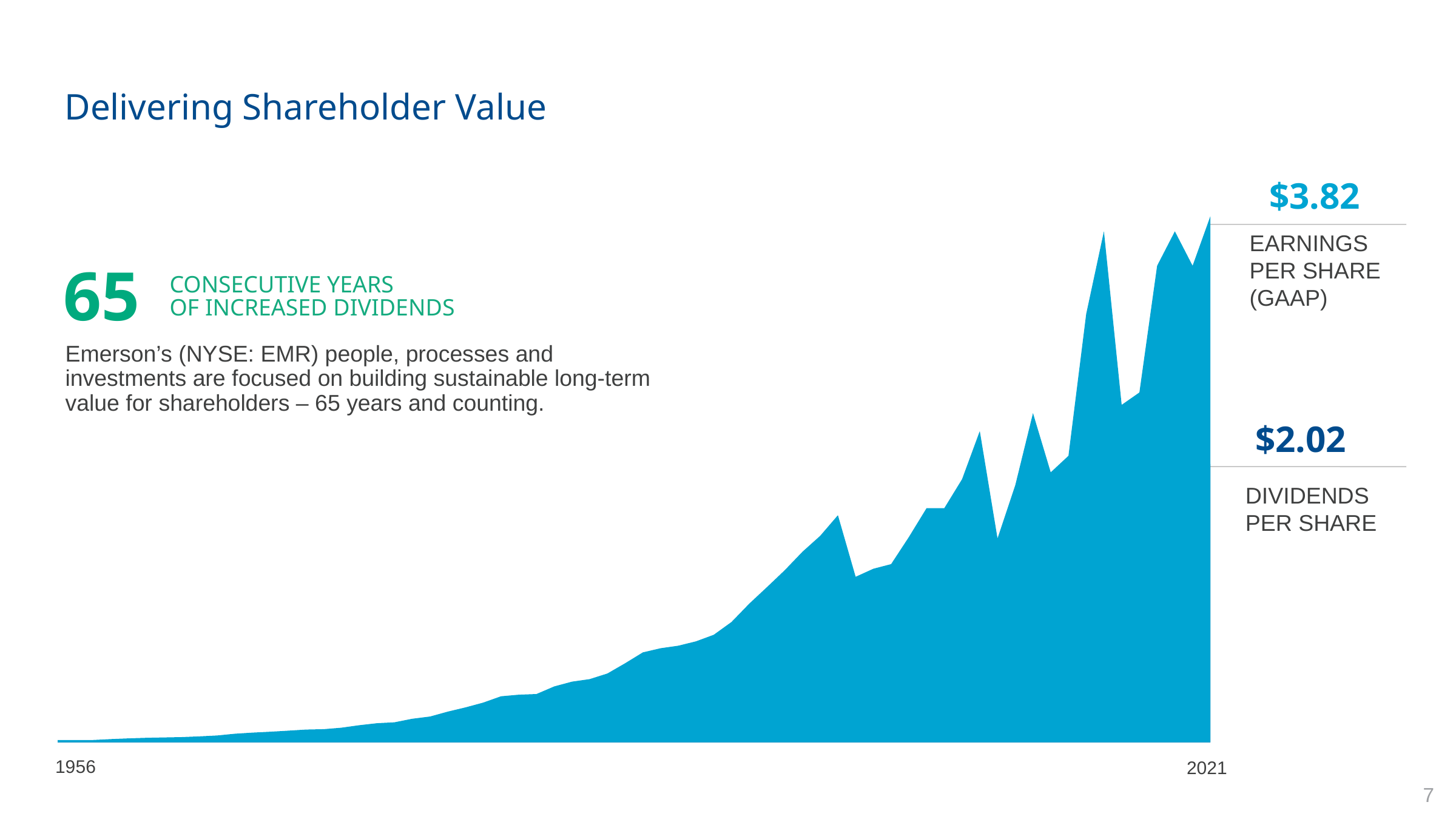
What is the last year shown on the chart's x axis? 2021 Do the values on the chart generally rise or fall from 1956 to 2021? Rise What kind of chart is shown on the slide? Area chart What is the title of the slide containing the chart? Delivering Shareholder Value What is the difference between the earnings per share (GAAP) value and the dividends per share value shown on the chart? $1.80 Which is larger on the chart, earnings per share (GAAP) or dividends per share? Earnings per share (GAAP) What is the dividends per share value labelled at the end of the chart? $2.02 What is the first year shown on the chart's x axis? 1956 What colour is the filled area of the chart? Blue What is the earnings per share (GAAP) value labelled at the end of the chart? $3.82